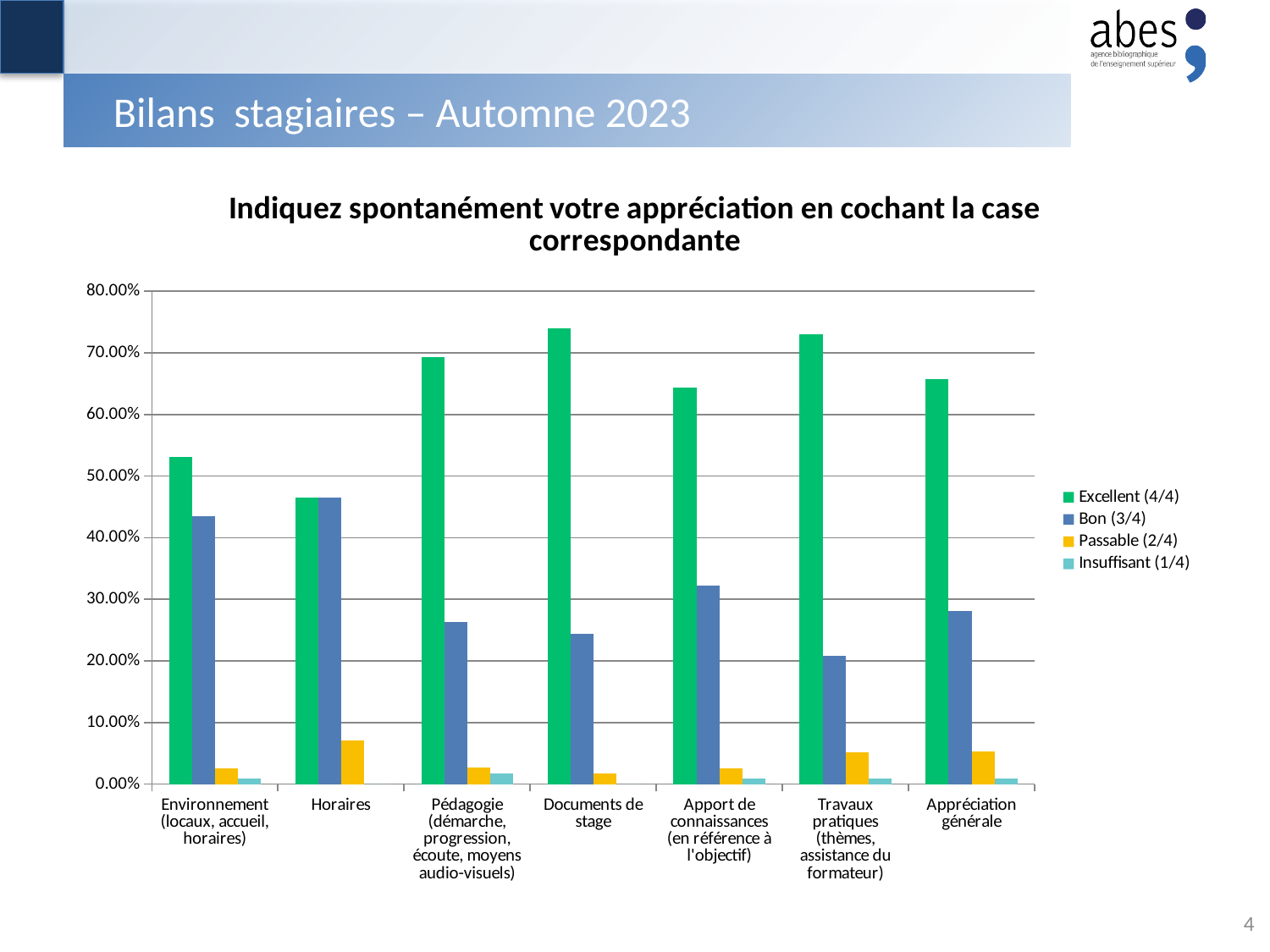
What kind of chart is shown on the slide? bar chart Is the Bon (3/4) value for Apport de connaissances (en référence à l'objectif) greater or less than 30.00%? greater Which series is shown in yellow in the legend? Passable (2/4) Which category has the highest value for the Passable (2/4) series? Horaires How many series does the legend list? 4 How many categories are shown on the x axis? 7 Is the Excellent (4/4) value for Environnement (locaux, accueil, horaires) greater or less than 50.00%? greater Which category has the lowest value for the Excellent (4/4) series? Horaires For Apport de connaissances (en référence à l'objectif), which is larger: the Excellent (4/4) value or the Bon (3/4) value? Excellent (4/4) Which category has the highest value for the Bon (3/4) series? Horaires Is the Passable (2/4) value for Horaires greater or less than 10.00%? less